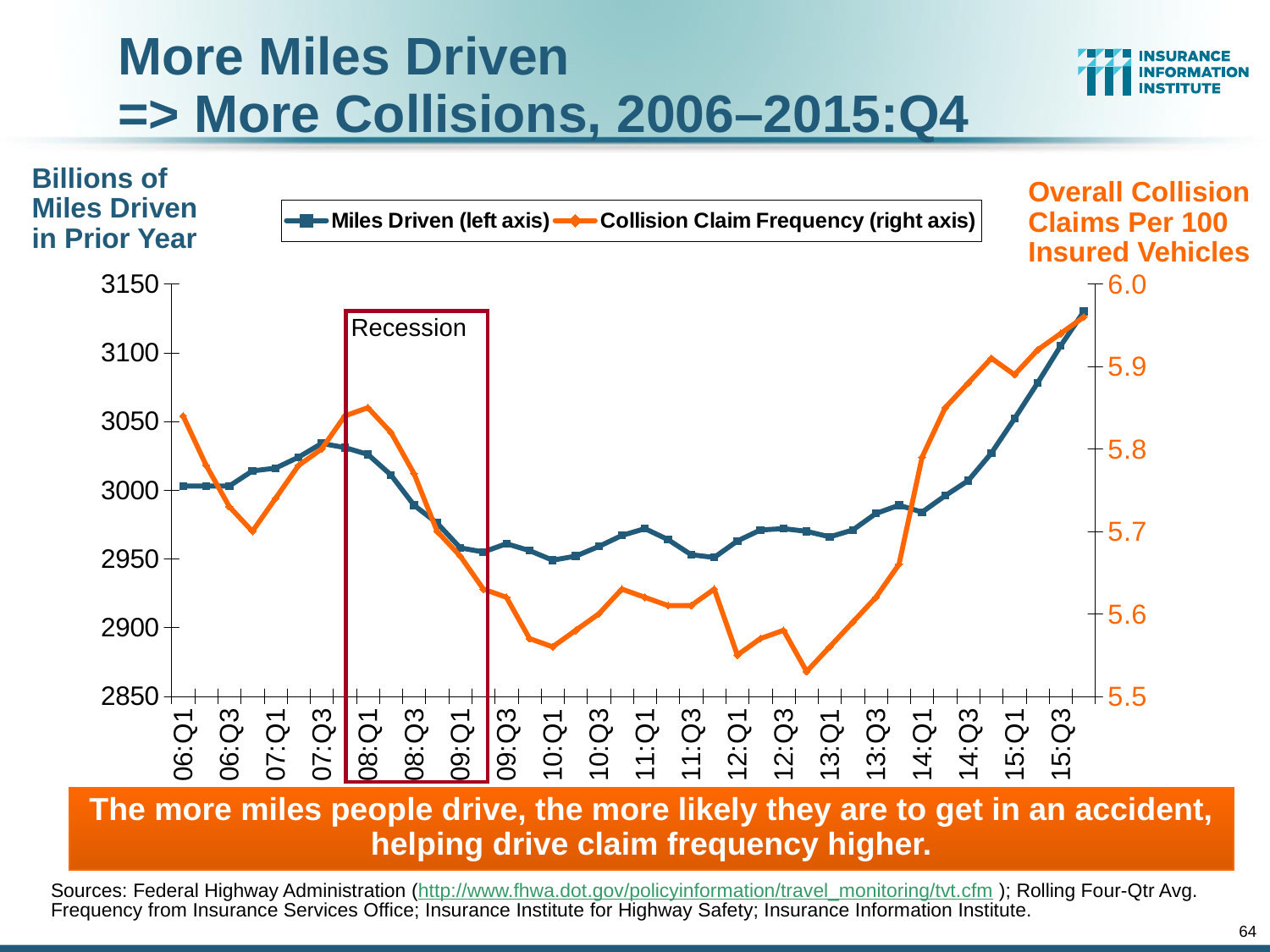
Is the Collision Claim Frequency at 08:Q1 greater or less than 5.8? greater Does Collision Claim Frequency rise or fall from 08:Q1 to 09:Q3? fall What kind of chart is shown on the slide? line chart Which is larger, Miles Driven at 07:Q3 or at 10:Q1? 07:Q3 Is the value of Miles Driven at 15:Q1 greater or less than 3000? greater What period is marked by the red box on the chart? Recession How many series does the legend list? 2 Is the value of Miles Driven at 10:Q1 greater or less than 3000? less Which series is plotted against the right axis? Collision Claim Frequency How many quarter labels are shown on the x axis? 20 Does Miles Driven rise or fall from 13:Q3 to 15:Q3? rise